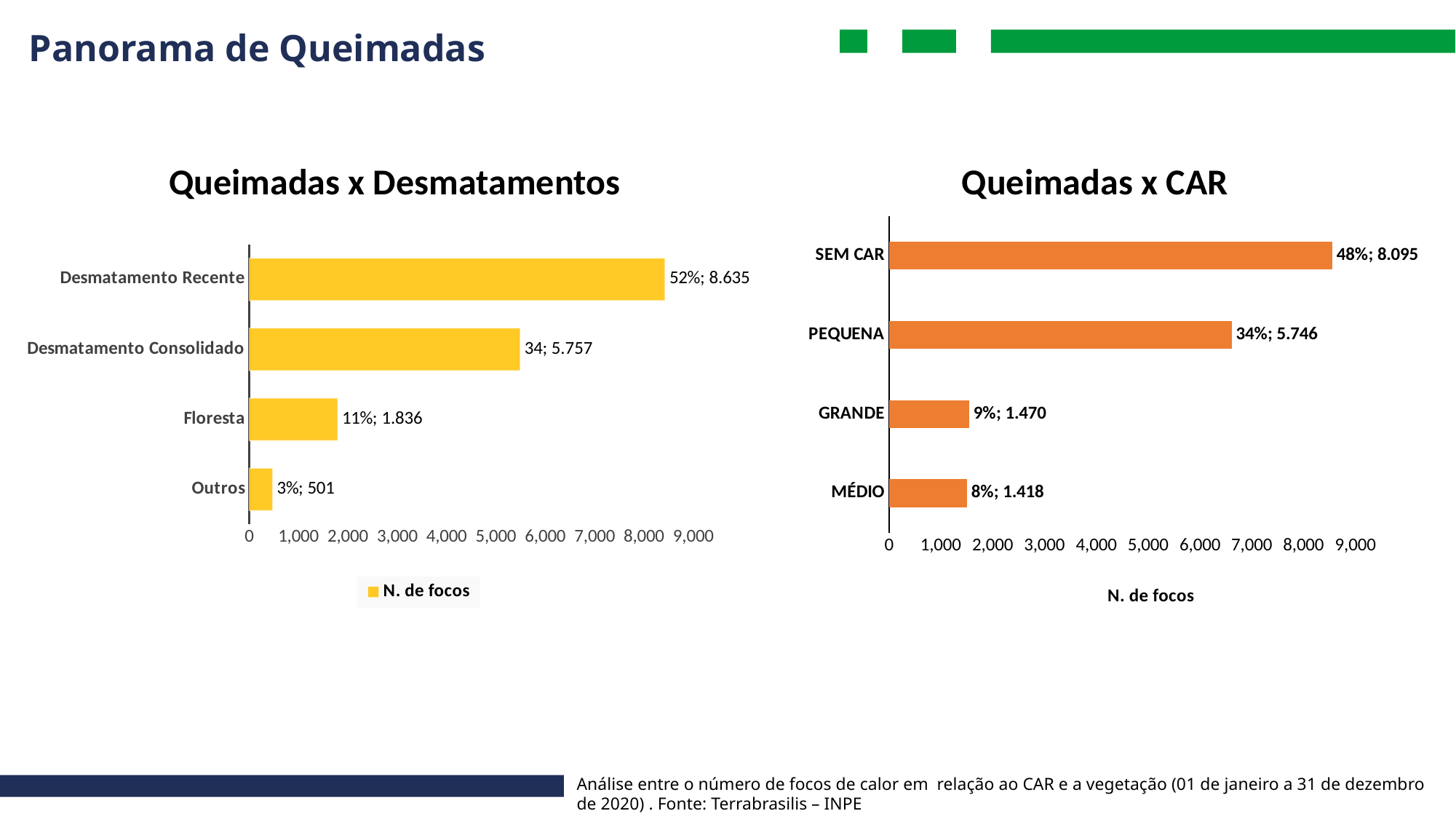
In the 'Queimadas x CAR' chart, is the value for PEQUENA greater or less than 5,000? greater In the 'Queimadas x CAR' chart, which is larger, the value for PEQUENA or the value for GRANDE? PEQUENA What type of chart is the 'Queimadas x CAR' chart? Bar chart In the 'Queimadas x Desmatamentos' chart, what series name does the legend show? N. de focos In the 'Queimadas x Desmatamentos' chart, which category has the lowest number of focos? Outros In the 'Queimadas x CAR' chart, what colour are the bars? Orange In the 'Queimadas x Desmatamentos' chart, what is the data label for Floresta? 11%; 1.836 In the 'Queimadas x Desmatamentos' chart, what is the data label for Desmatamento Recente? 52%; 8.635 In the 'Queimadas x Desmatamentos' chart, how many categories are shown? 4 In the 'Queimadas x CAR' chart, what is the data label for MÉDIO? 8%; 1.418 In the 'Queimadas x CAR' chart, which category has the highest number of focos? SEM CAR In the 'Queimadas x CAR' chart, what is the data label for SEM CAR? 48%; 8.095